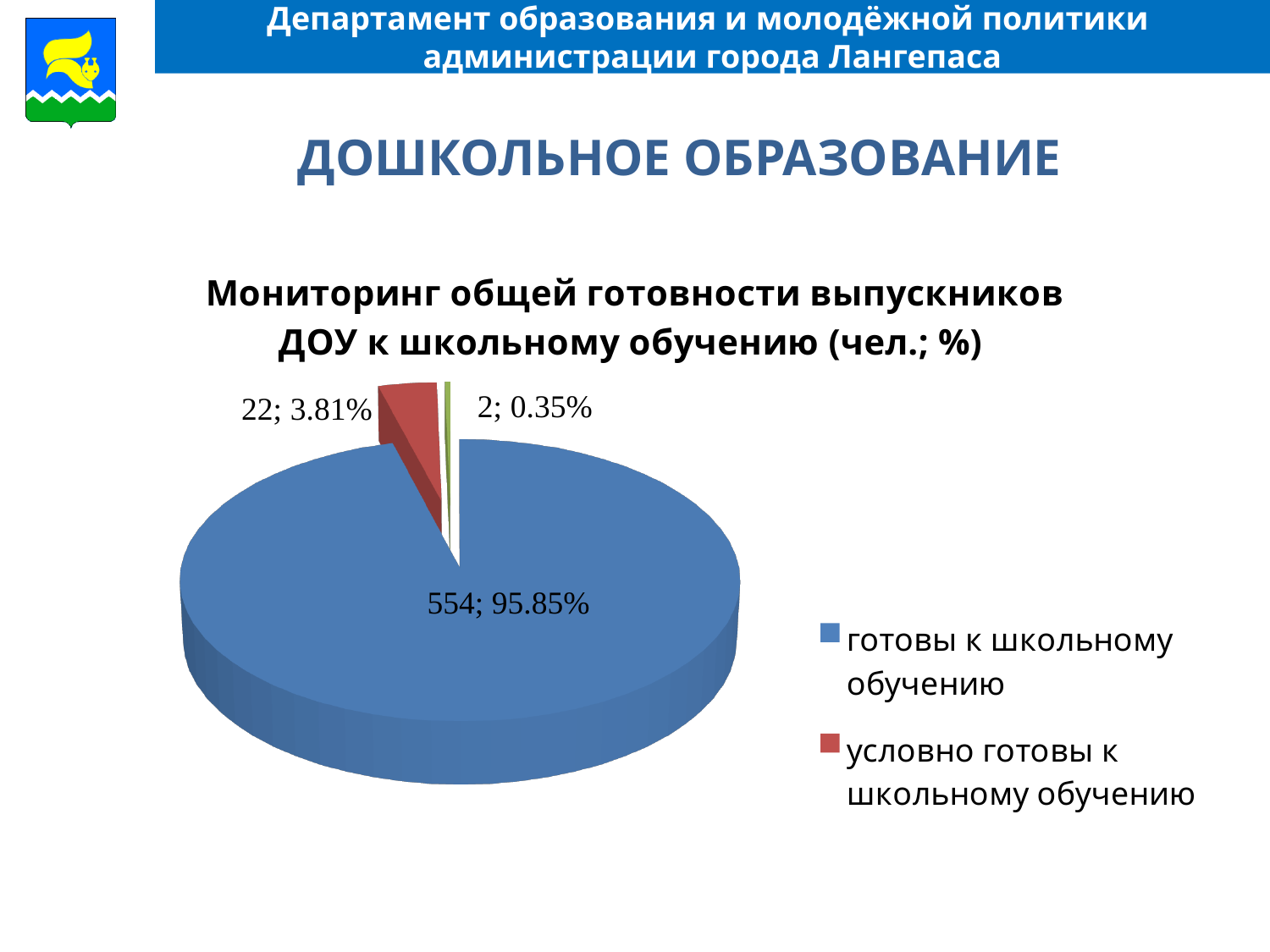
How many people are in the 'готовы к школьному обучению' slice? 554 How many people are in the 'условно готовы к школьному обучению' slice? 22 What kind of chart is shown on the slide? pie chart What is the smallest value shown on the pie chart? 2 Which is larger: the 'готовы к школьному обучению' slice or the 'условно готовы к школьному обучению' slice? готовы к школьному обучению How many slices does the pie chart have? 3 What share of the pie does the 'условно готовы к школьному обучению' slice represent? 3.81% How many entries does the legend list? 2 What is the difference between the 'готовы к школьному обучению' value and the 'условно готовы к школьному обучению' value? 532 What colour is the 'условно готовы к школьному обучению' slice? red Which category has the largest slice of the pie? готовы к школьному обучению What share of the pie does the 'готовы к школьному обучению' slice represent? 95.85%